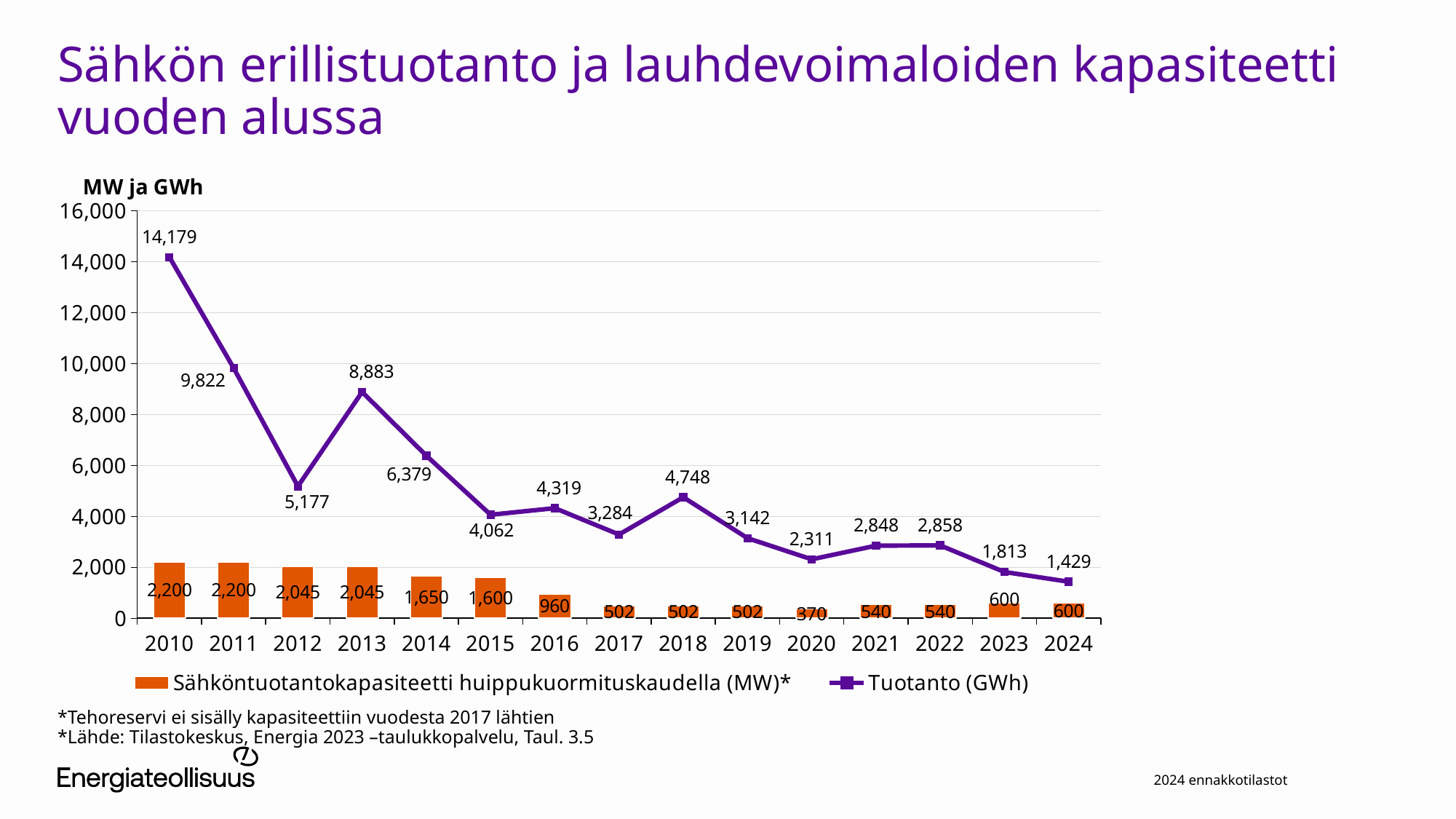
What kinds of chart are combined on this slide? Bar chart and line chart Which is larger, the Tuotanto (GWh) value for 2018 or for 2016? 2018 What is the difference between the Tuotanto (GWh) values for 2013 and 2012? 3,706 Which year has the highest Tuotanto (GWh) value? 2010 How many series does the legend list? 2 How many years are shown on the x axis? 15 Is the Tuotanto (GWh) value for 2014 greater or less than 6,000? greater What is the Tuotanto (GWh) value for 2010? 14,179 Does the Tuotanto (GWh) series generally rise or fall from 2010 to 2024? Fall What is the Sähköntuotantokapasiteetti huippukuormituskaudella (MW)* value for 2016? 960 Which year has the lowest Sähköntuotantokapasiteetti huippukuormituskaudella (MW)* value? 2020 What is the Tuotanto (GWh) value for 2024? 1,429